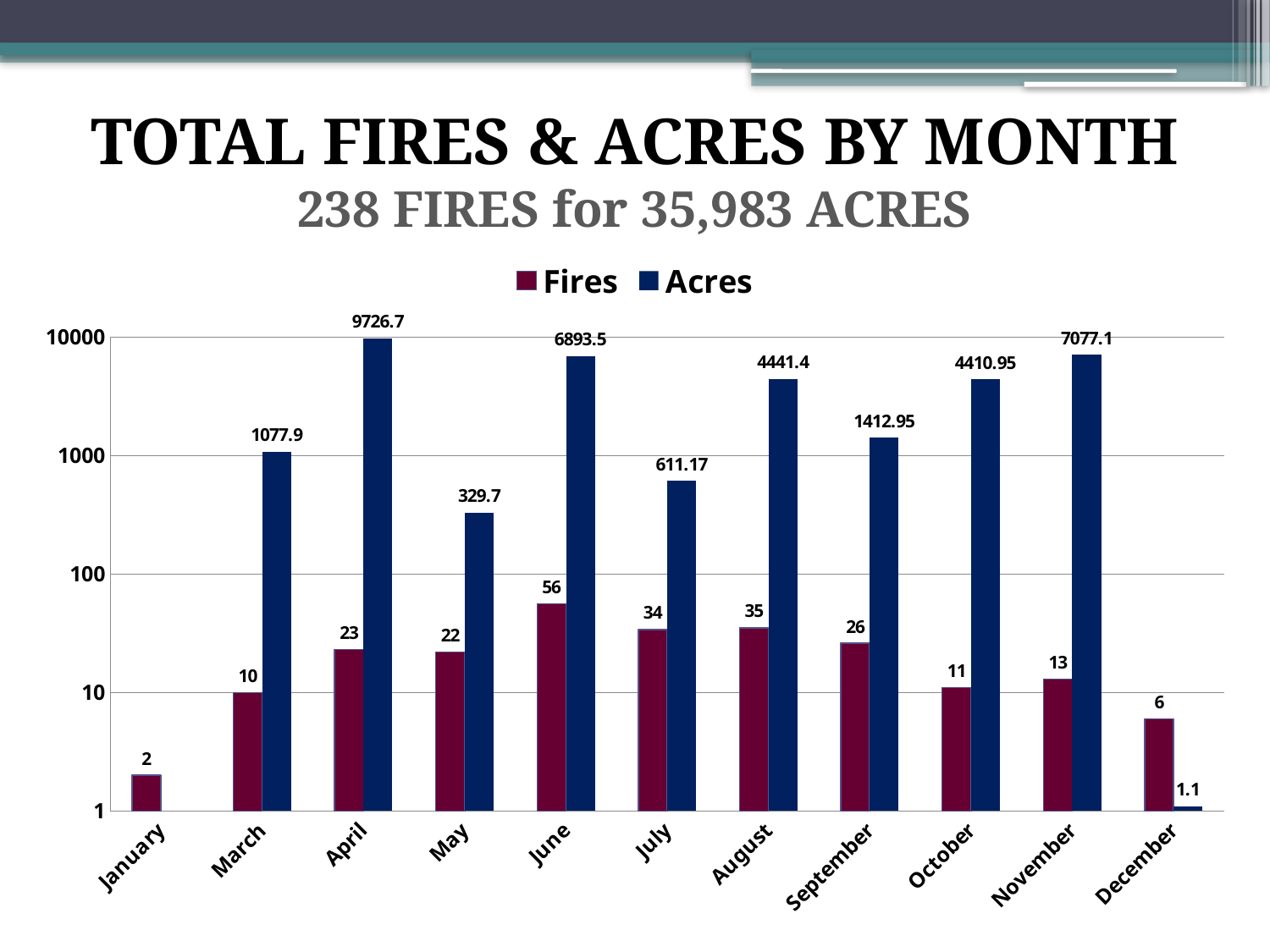
What is the value for Acres in April? 9726.7 How many series does the legend list? 2 What is the difference between the Fires values for June and July? 22 What is the value for Fires in June? 56 Is the value for Acres in May greater or less than 1000? less What kind of chart is shown on the slide? bar chart Which month has the lowest value for Fires? January What is the title of the chart? TOTAL FIRES & ACRES BY MONTH How many months are shown on the x axis? 11 What is the value for Acres in September? 1412.95 Which month has the highest value for Acres? April Which is larger, the Acres value for June or the Acres value for November? November